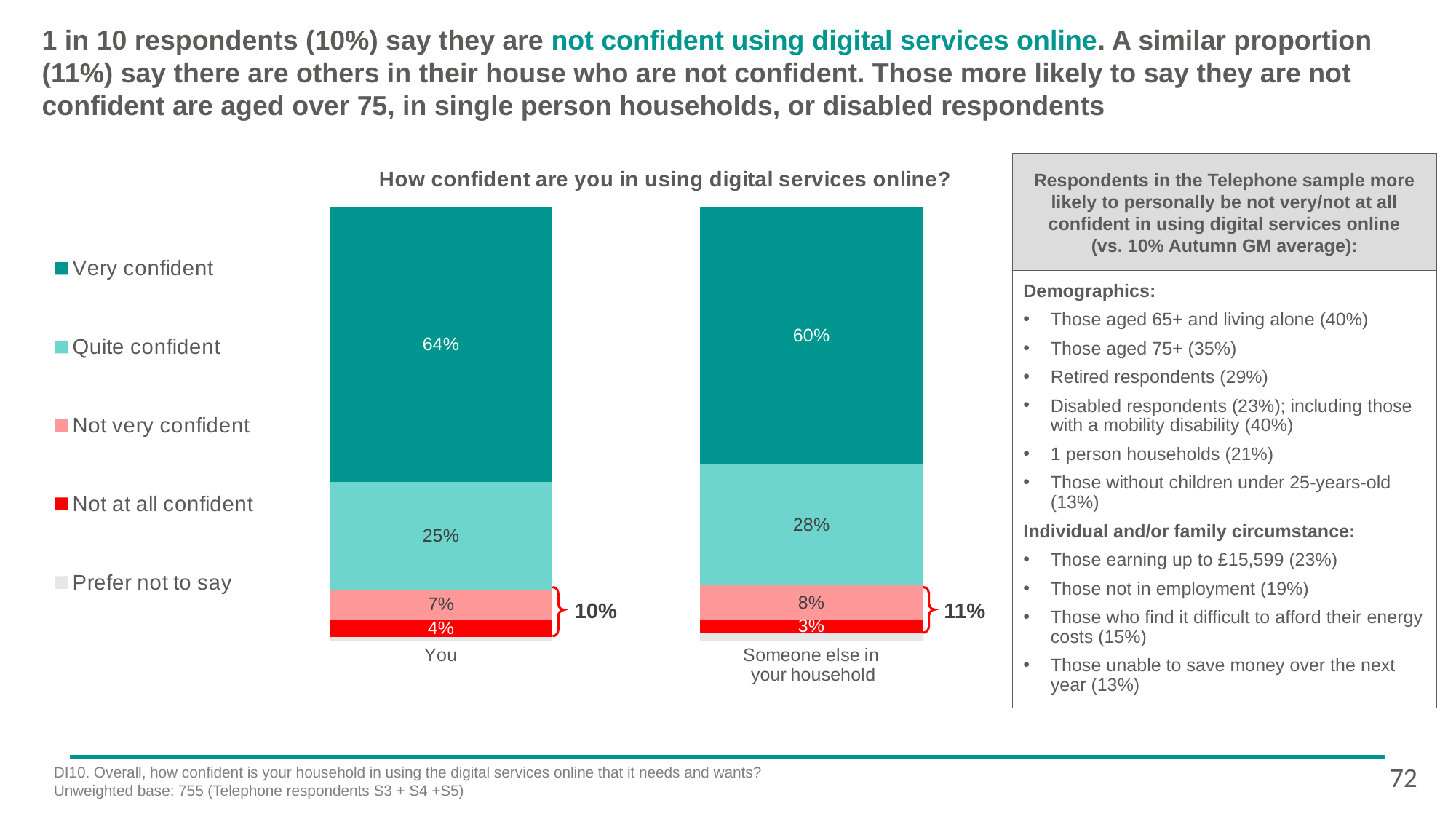
What is the title of the chart? How confident are you in using digital services online? What percentage is shown for 'Not very confident' in the 'Someone else in your household' bar? 8% How many series does the chart legend list? 5 What is the combined 'Not very confident' and 'Not at all confident' share for 'Someone else in your household', as labelled by the bracket? 11% What type of chart is used to show confidence in using digital services online? Stacked bar chart What percentage is shown for 'Quite confident' in the 'Someone else in your household' bar? 28% What percentage of respondents say they are very confident using digital services online for 'You'? 64% Which bar has the higher 'Very confident' value, 'You' or 'Someone else in your household'? You What is the combined 'Not very confident' and 'Not at all confident' share for 'You', as labelled by the bracket? 10% What percentage is shown for 'Not at all confident' in the 'You' bar? 4% What is the difference between the 'Quite confident' values for 'Someone else in your household' and 'You'? 3% How many bars (categories) are shown on the x axis of the chart? 2